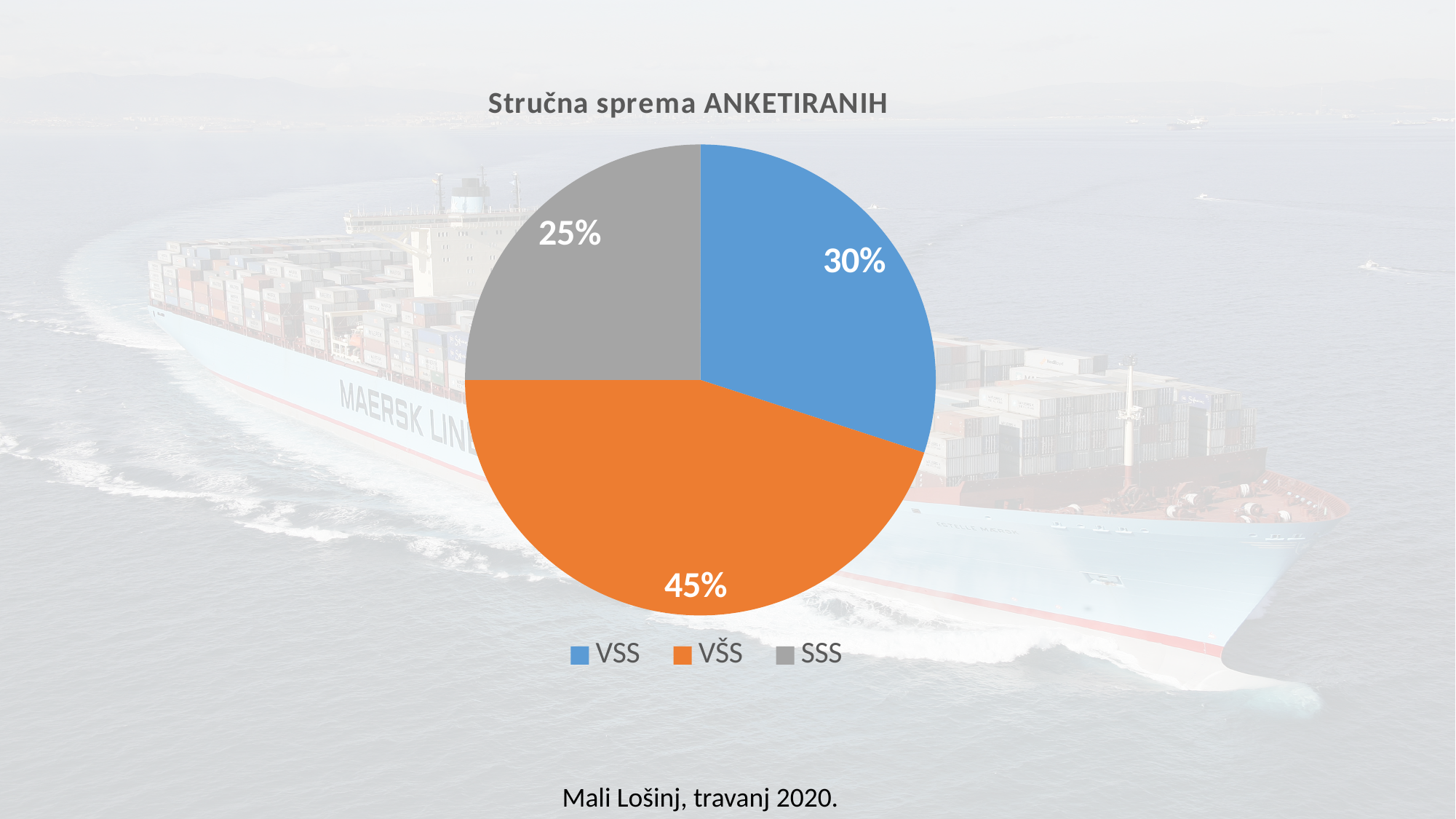
What is the difference in percentage points between the VŠS and VSS slices? 15 How many categories does the pie chart show? 3 Which colour represents VŠS in the legend? Orange What kind of chart is shown on the slide? Pie chart Which category has the smallest slice of the pie? SSS Which is larger, the VSS slice or the SSS slice? VSS What is the title of the chart? Stručna sprema ANKETIRANIH What share of the pie does SSS represent? 25% Which category has the largest slice of the pie? VŠS What share of the pie does VSS represent? 30% What share of the pie does VŠS represent? 45% What is the difference in percentage points between the VSS and SSS slices? 5